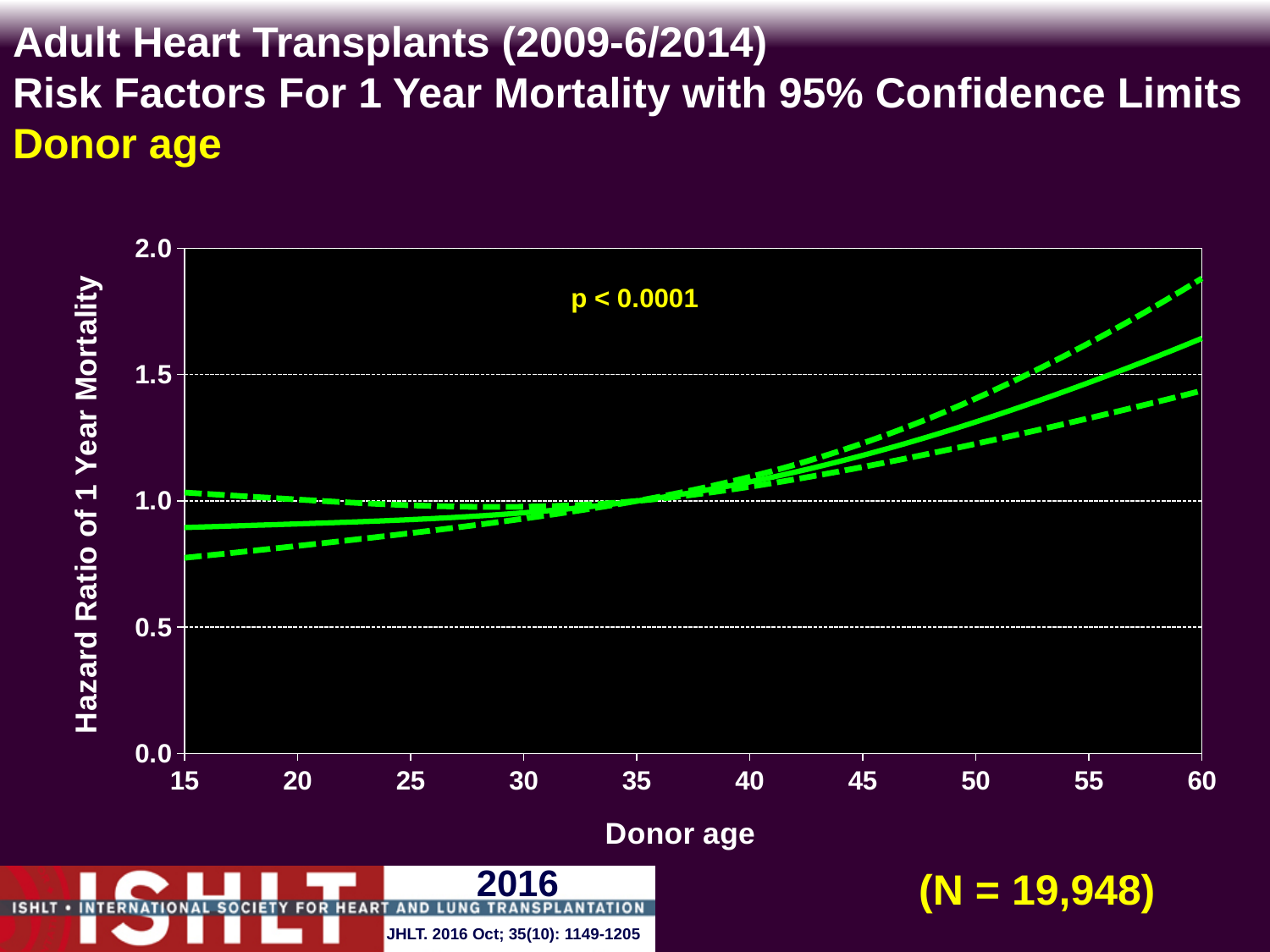
Is the lower dashed confidence limit at donor age 15 greater or less than 1.0? less How many lines are plotted on the chart? 3 Is the hazard ratio on the solid line higher at donor age 60 or at donor age 15? donor age 60 Is the hazard ratio on the solid line at donor age 15 greater or less than 1.0? less What p-value is printed on the chart? p < 0.0001 Does the hazard ratio of 1 year mortality rise or fall as donor age increases from 15 to 60? rise Is the hazard ratio on the solid line at donor age 60 greater or less than 1.5? greater What is the label of the x axis? Donor age What kind of chart is shown on the slide? line chart